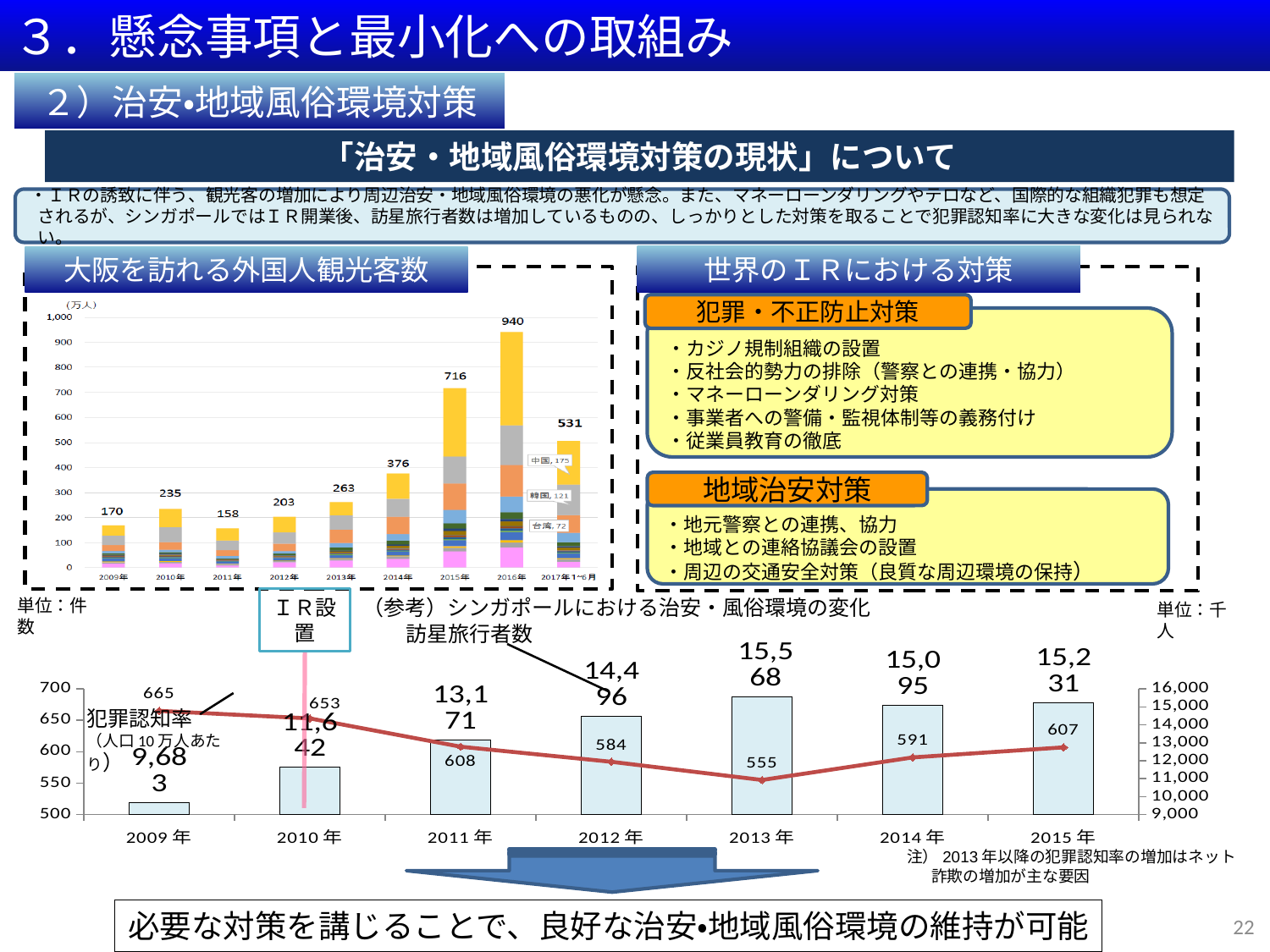
In the chart titled 大阪を訪れる外国人観光客数, how many bars (time periods) are shown? 9 What kind of chart is the chart titled 大阪を訪れる外国人観光客数? Stacked bar chart In the chart titled 大阪を訪れる外国人観光客数, which year has the lowest total? 2011年 In the chart titled 大阪を訪れる外国人観光客数, what is the value labelled for 中国 in the 2017年1~6月 bar? 175 In the bottom chart (シンガポールにおける治安・風俗環境の変化), is the 犯罪認知率 for 2014年 larger or smaller than for 2015年? smaller In the bottom chart (シンガポールにおける治安・風俗環境の変化), what is the 犯罪認知率 value for 2013年? 555 In the bottom chart (シンガポールにおける治安・風俗環境の変化), what is the 訪星旅行者数 value for 2012年? 14,496 In the bottom chart (シンガポールにおける治安・風俗環境の変化), what is the difference in 犯罪認知率 between 2009年 and 2013年? 110 In the chart titled 大阪を訪れる外国人観光客数, what is the value for 2016年? 940 In the bottom chart (シンガポールにおける治安・風俗環境の変化), which year has the highest 犯罪認知率? 2009年 In the chart titled 大阪を訪れる外国人観光客数, what is the difference between the 2016年 total and the 2015年 total? 224 In the bottom chart (シンガポールにおける治安・風俗環境の変化), which year has the highest 訪星旅行者数? 2013年